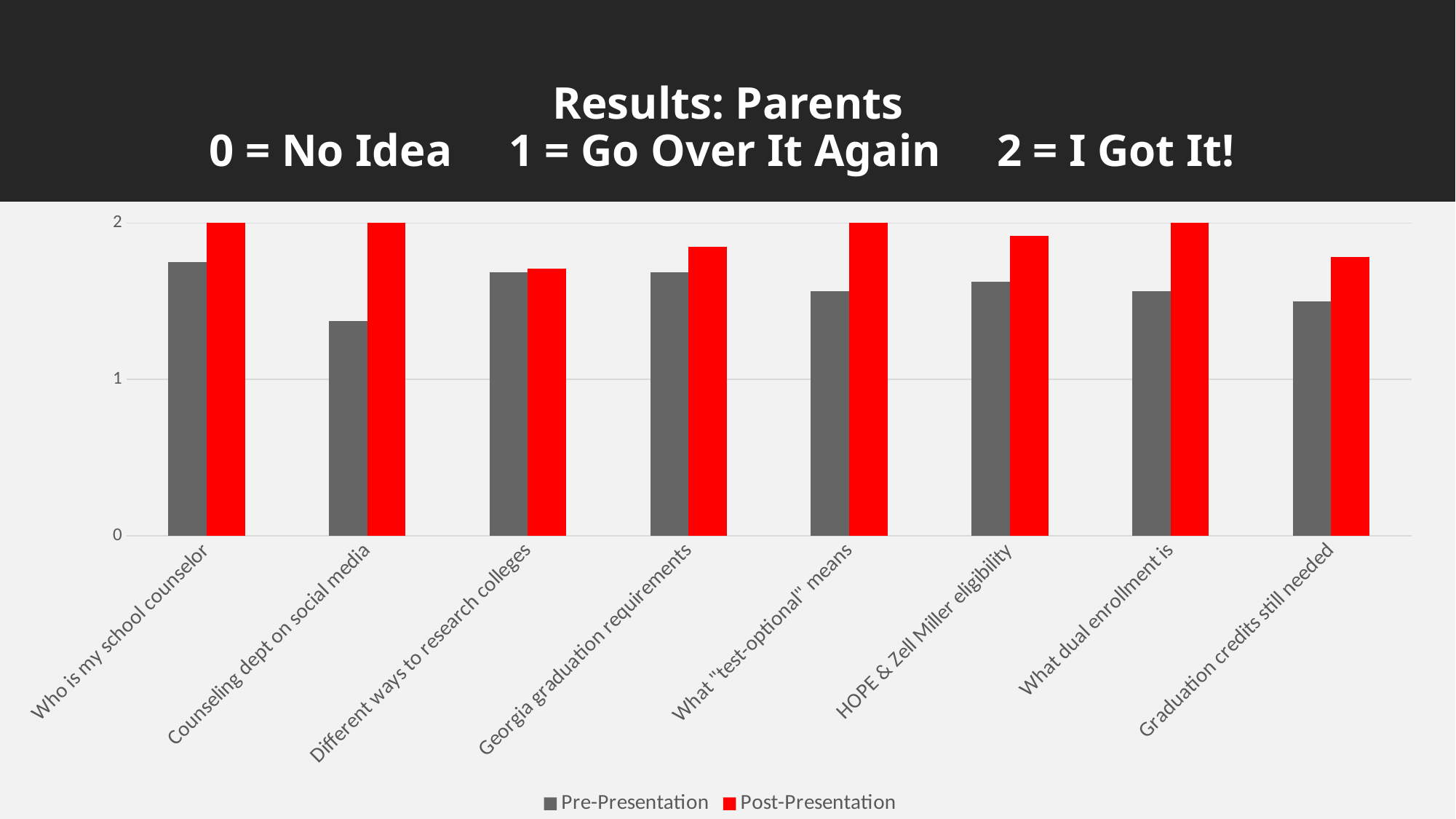
Is the Pre-Presentation value for "Graduation credits still needed" greater or less than 2? less What is the Post-Presentation value for "Who is my school counselor"? 2 How many series does the chart's legend list? 2 Which colour represents the Post-Presentation series in the chart? red For "What "test-optional" means", which is larger: the Pre-Presentation value or the Post-Presentation value? Post-Presentation Which category has the lowest Pre-Presentation value? Counseling dept on social media Is the Pre-Presentation value for "Counseling dept on social media" greater or less than 1? greater According to the slide title, what does a score of 2 mean? I Got It! What kind of chart is shown on the slide? bar chart For "Counseling dept on social media", which is larger: the Pre-Presentation value or the Post-Presentation value? Post-Presentation What is the Post-Presentation value for "What dual enrollment is"? 2 How many categories are shown along the x axis of the chart? 8